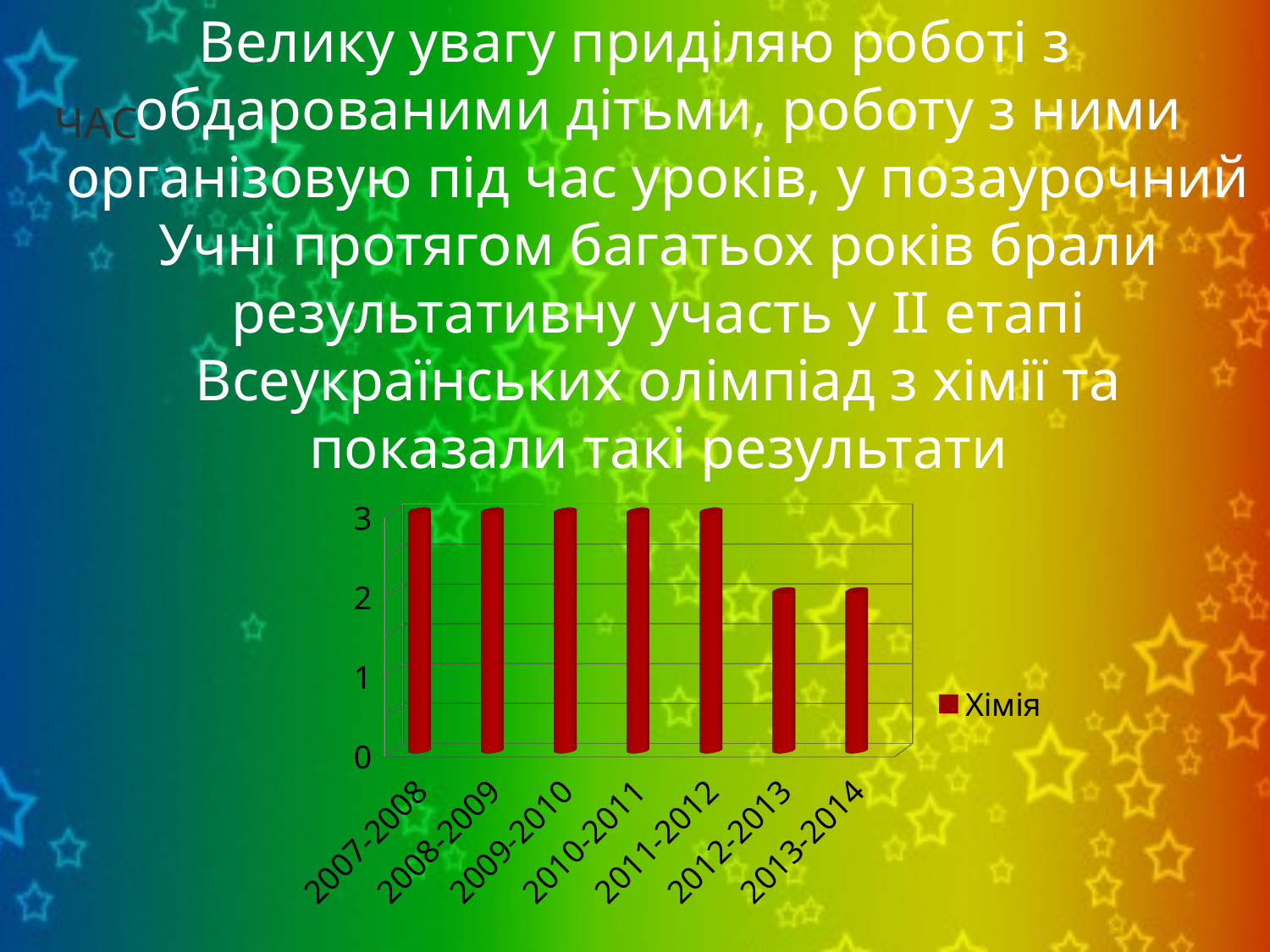
Do the values rise or fall from 2007-2008 to 2013-2014? fall Is the value for 2008-2009 greater or less than 2? greater What is the difference between the value for 2009-2010 and the value for 2013-2014? 1 How many series does the legend list? 1 What is the name of the series listed in the legend? Хімія How many categories (school years) are shown on the x axis? 7 What is the value for 2013-2014? 2 Which is larger, the value for 2011-2012 or the value for 2012-2013? 2011-2012 What is the value for 2010-2011? 3 What kind of chart is shown on the slide? bar chart What is the value for 2012-2013? 2 What is the value for 2007-2008? 3